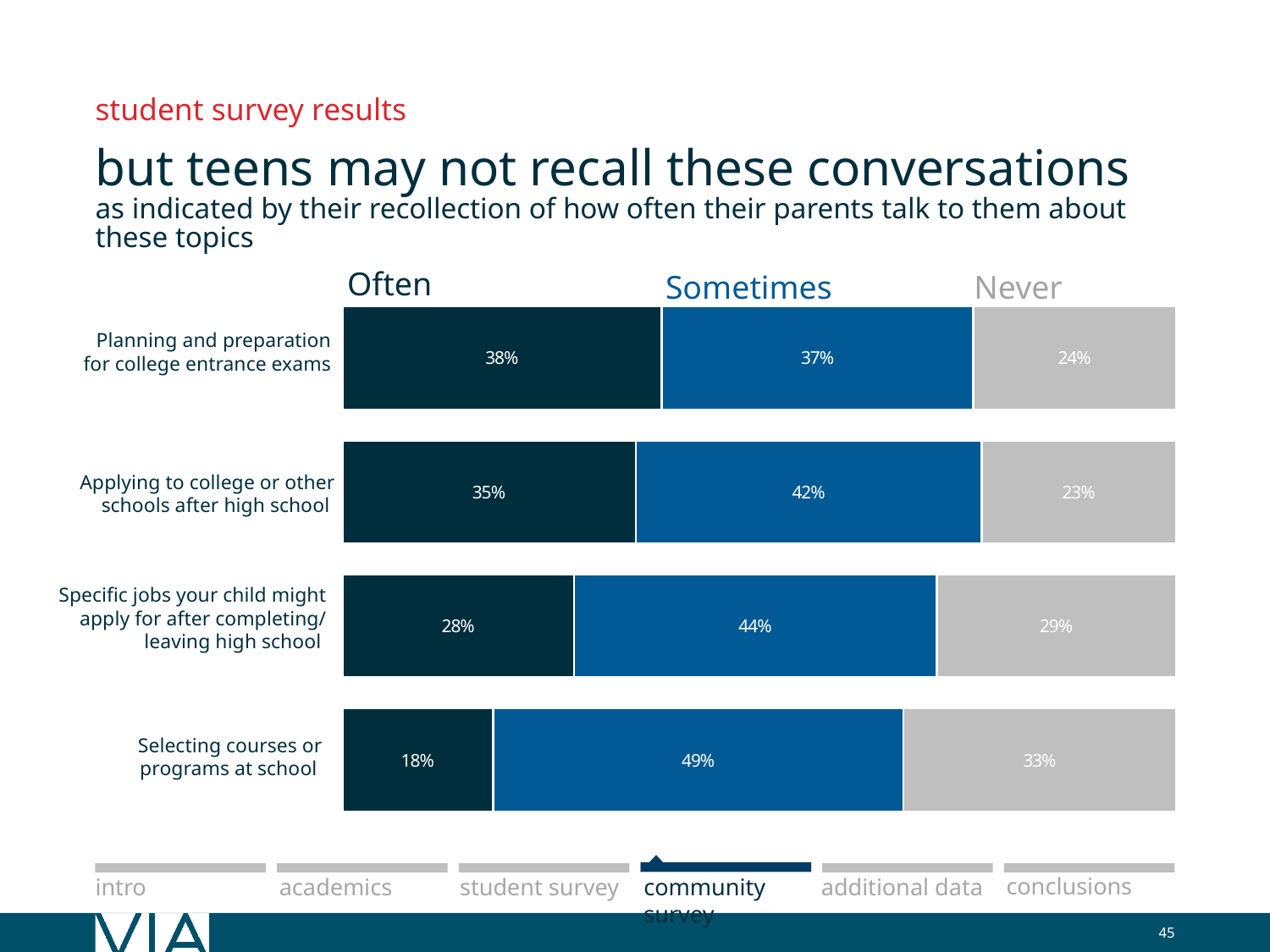
What is the 'Never' value for 'Specific jobs your child might apply for after completing/leaving high school'? 29% What is the 'Sometimes' value for 'Selecting courses or programs at school'? 49% How many topics (categories) are shown in the chart? 4 What percentage of teens said their parents 'Often' talk to them about planning and preparation for college entrance exams? 38% Which topic has the lowest 'Often' value? Selecting courses or programs at school What are the three response categories labelled above the bars? Often, Sometimes, Never How many response categories (series) does the chart show? 3 What is the difference between the 'Sometimes' and 'Often' values for 'Applying to college or other schools after high school'? 7% Which topic has the highest 'Often' value? Planning and preparation for college entrance exams Which topic has the highest 'Never' value? Selecting courses or programs at school What kind of chart is shown on the slide? Stacked bar chart Is the 'Never' value larger for 'Planning and preparation for college entrance exams' or for 'Selecting courses or programs at school'? Selecting courses or programs at school